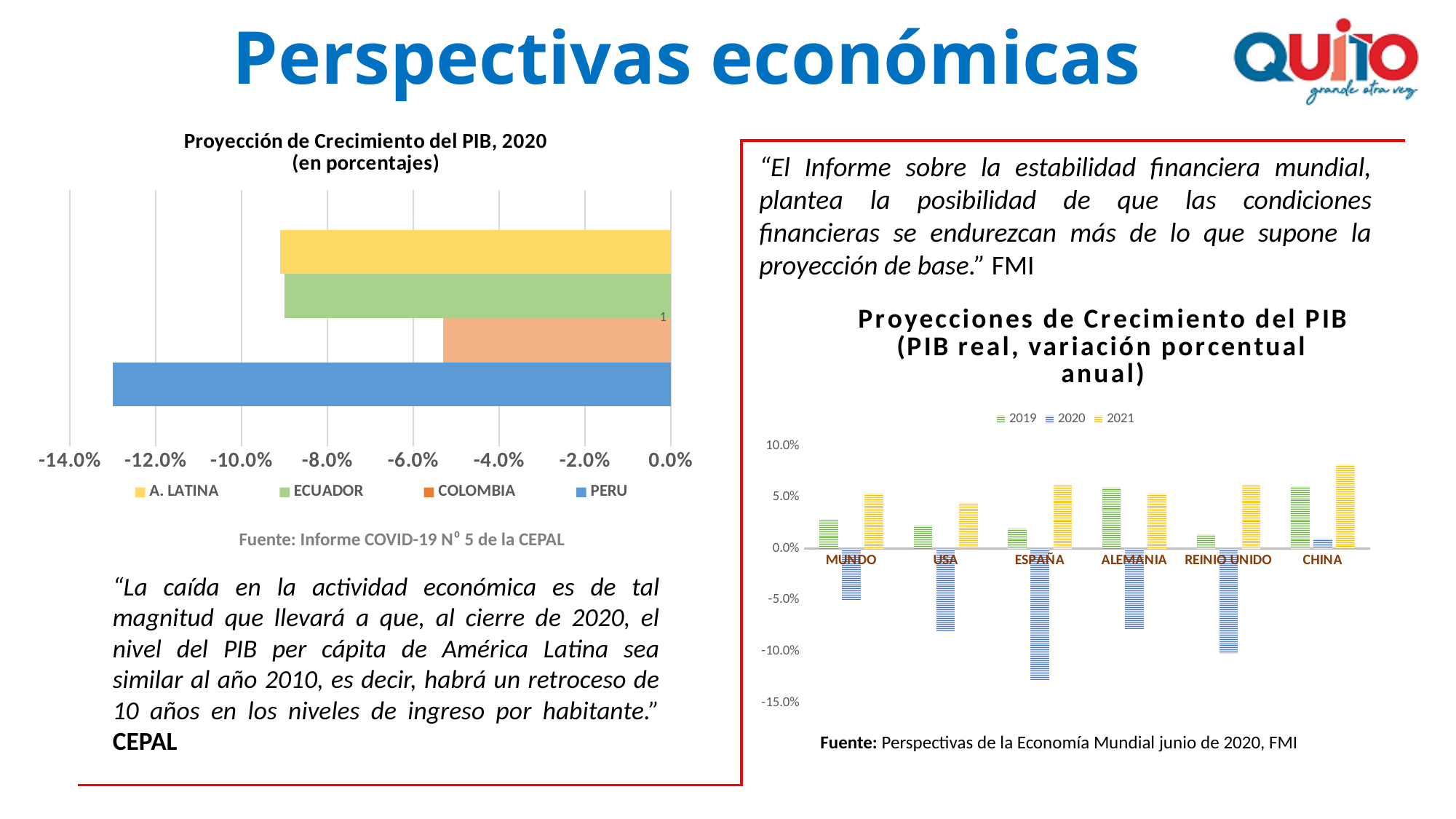
In the 'Proyecciones de Crecimiento del PIB' chart on the right, which is larger, the 2020 value for CHINA or the 2020 value for USA? CHINA In the 'Proyección de Crecimiento del PIB, 2020' chart on the left, which is larger, the value for COLOMBIA or the value for PERU? COLOMBIA In the 'Proyección de Crecimiento del PIB, 2020' chart on the left, which category has the lowest (most negative) value? PERU In the 'Proyecciones de Crecimiento del PIB' chart on the right, which category has the lowest 2020 value? ESPAÑA In the 'Proyección de Crecimiento del PIB, 2020' chart on the left, is the value for COLOMBIA greater or less than -6.0%? greater In the 'Proyección de Crecimiento del PIB, 2020' chart on the left, is the value for PERU greater or less than -12.0%? less How many countries or regions are shown in the 'Proyección de Crecimiento del PIB, 2020' chart on the left? 4 What kind of chart is the 'Proyección de Crecimiento del PIB, 2020' chart on the left? bar chart How many countries or regions are shown on the x axis of the 'Proyecciones de Crecimiento del PIB' chart on the right? 6 In the 'Proyección de Crecimiento del PIB, 2020' chart on the left, which category has the highest (least negative) value? COLOMBIA How many series does the legend list in the 'Proyecciones de Crecimiento del PIB' chart on the right? 3 In the 'Proyecciones de Crecimiento del PIB' chart on the right, is the 2020 value for ESPAÑA greater or less than -10.0%? less